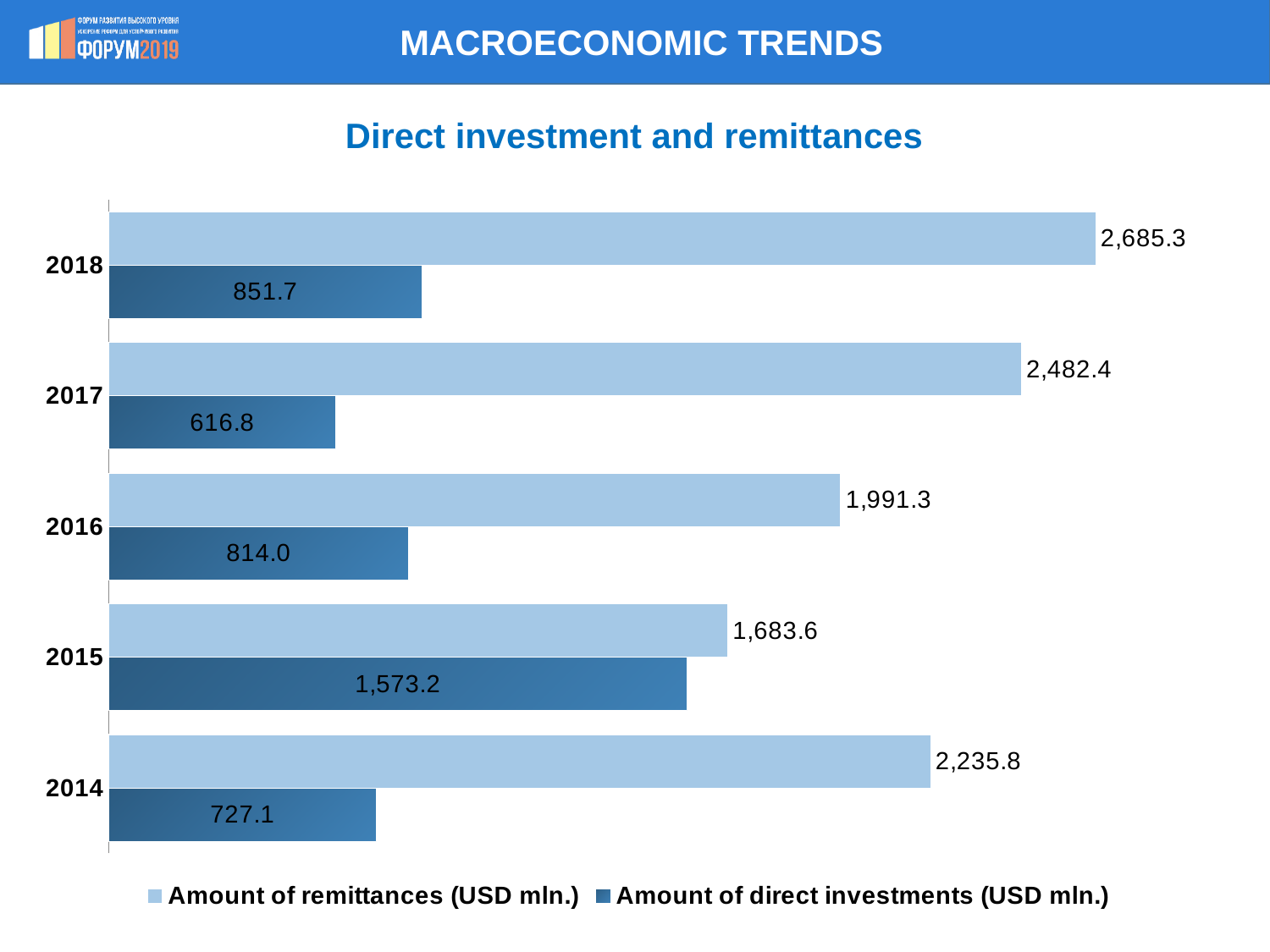
What is the title of the chart? Direct investment and remittances What kind of chart is shown on the slide? Bar chart What is the amount of direct investments (USD mln.) for 2015? 1,573.2 What is the amount of remittances (USD mln.) for 2018? 2,685.3 Which year has the lowest amount of remittances? 2015 What is the difference between the amount of remittances and the amount of direct investments in 2018? 1,833.6 What is the amount of direct investments (USD mln.) for 2017? 616.8 How many series does the legend list? 2 Which year has the highest amount of remittances? 2018 Which year has the lowest amount of direct investments? 2017 How many years are shown on the chart? 5 Which is larger: the amount of direct investments in 2016 or in 2014? 2016